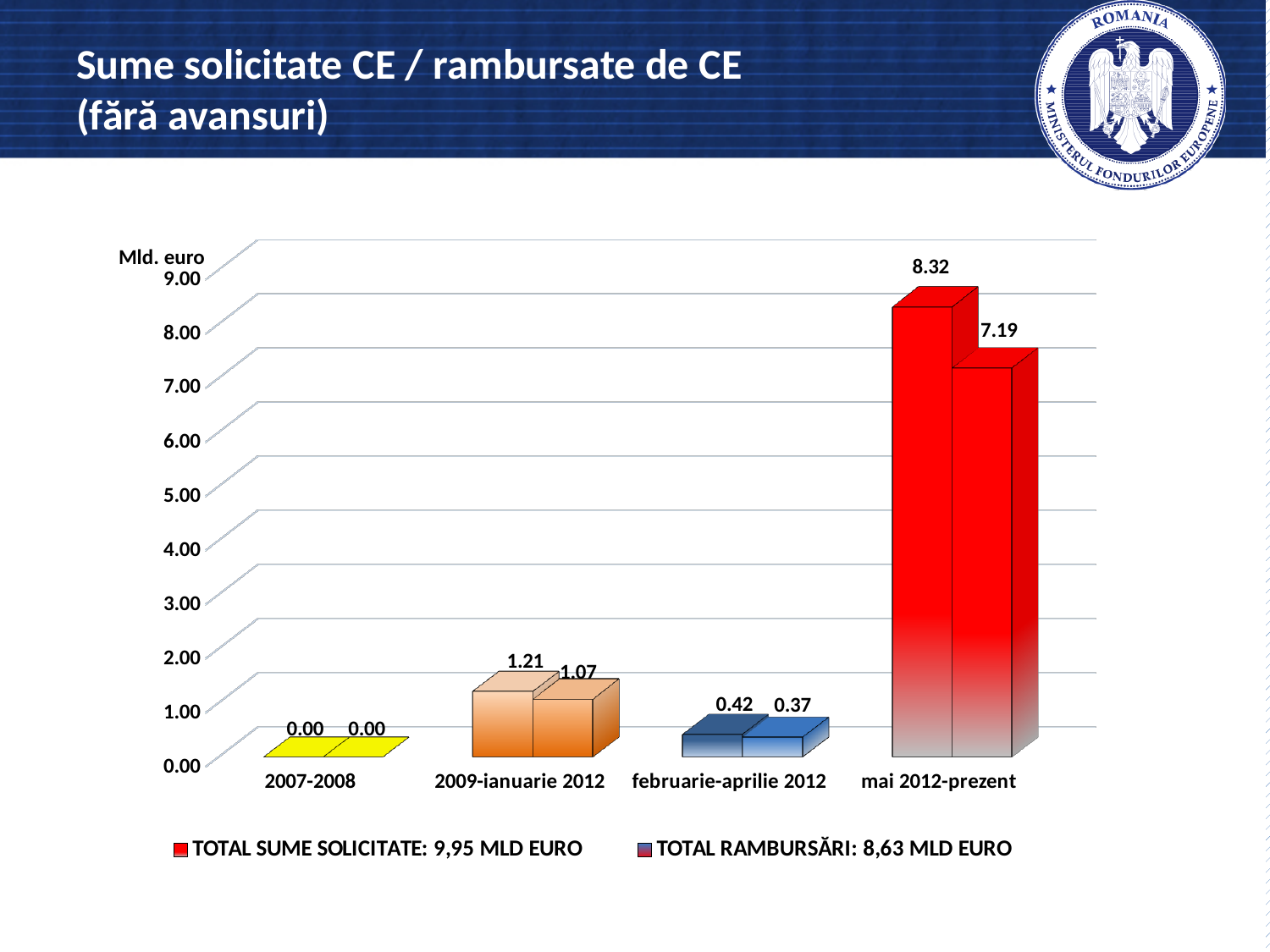
Which period has the lowest value for the TOTAL RAMBURSĂRI series? 2007-2008 Which period has the highest value for the TOTAL SUME SOLICITATE series? mai 2012-prezent What is the value of the TOTAL SUME SOLICITATE series for mai 2012-prezent? 8.32 What kind of chart is shown on the slide? bar chart What is the value of the TOTAL SUME SOLICITATE series for 2009-ianuarie 2012? 1.21 How many periods are shown on the x axis of the chart? 4 What is the value of the TOTAL RAMBURSĂRI series for februarie-aprilie 2012? 0.37 What is the difference between the TOTAL SUME SOLICITATE and TOTAL RAMBURSĂRI values for mai 2012-prezent? 1.13 Which is larger for 2009-ianuarie 2012: the TOTAL SUME SOLICITATE value or the TOTAL RAMBURSĂRI value? TOTAL SUME SOLICITATE Is the TOTAL RAMBURSĂRI value for mai 2012-prezent greater or less than 8.00? less What is the value of the TOTAL RAMBURSĂRI series for mai 2012-prezent? 7.19 How many series does the chart legend list? 2